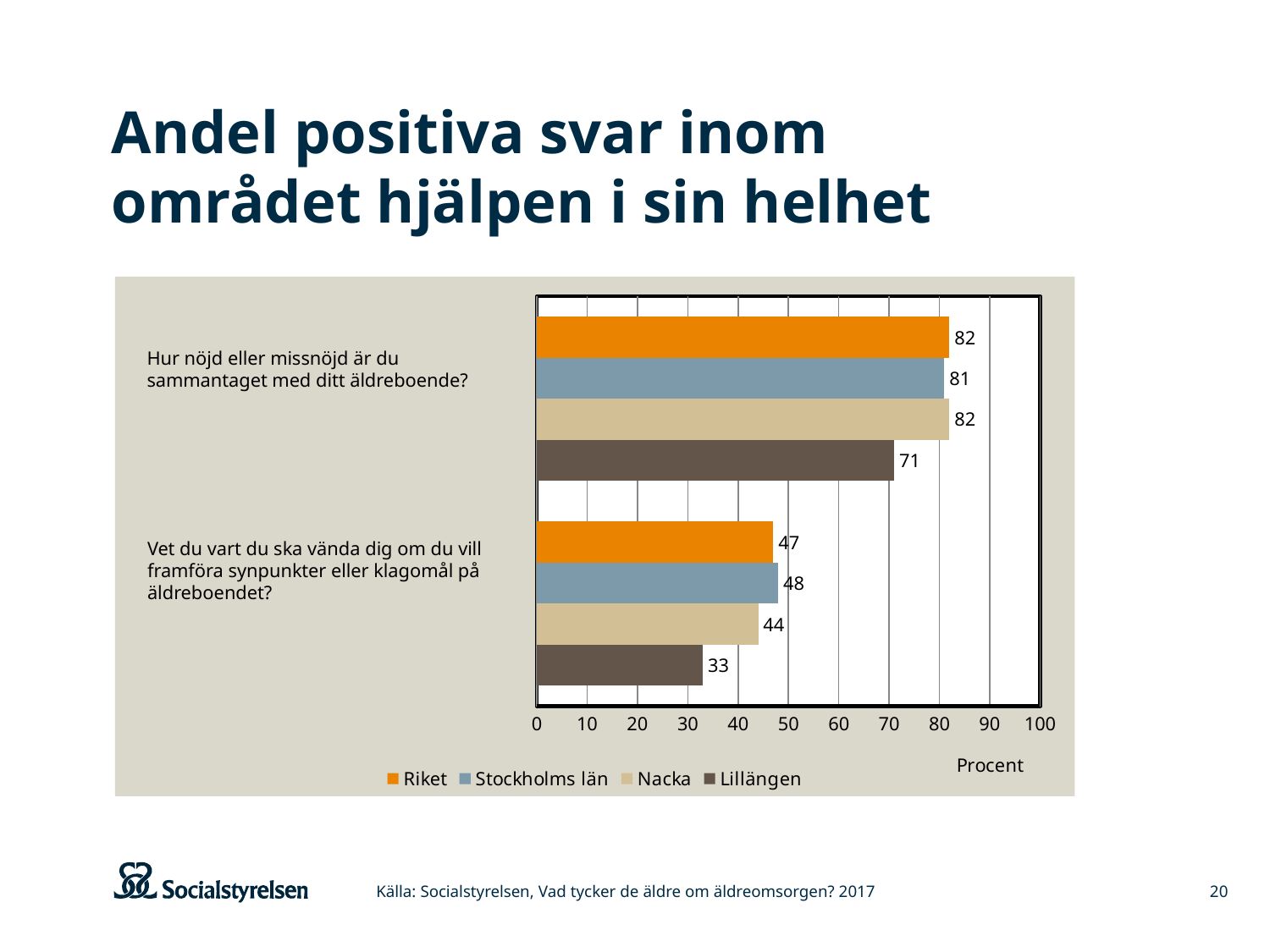
What is the label of the horizontal axis? Procent How many questions (categories) are shown on the chart? 2 Which is larger for Lillängen: the value for 'Hur nöjd eller missnöjd är du sammantaget med ditt äldreboende?' or the value for 'Vet du vart du ska vända dig om du vill framföra synpunkter eller klagomål på äldreboendet?' Hur nöjd eller missnöjd är du sammantaget med ditt äldreboende? What is the difference between Nacka and Lillängen on the question 'Hur nöjd eller missnöjd är du sammantaget med ditt äldreboende?' 11 What is the value for Riket on the question 'Hur nöjd eller missnöjd är du sammantaget med ditt äldreboende?' 82 Which series has the lowest value on the question 'Vet du vart du ska vända dig om du vill framföra synpunkter eller klagomål på äldreboendet?' Lillängen What type of chart is shown on the slide? bar chart What is the value for Stockholms län on the question 'Vet du vart du ska vända dig om du vill framföra synpunkter eller klagomål på äldreboendet?' 48 What is the value for Nacka on the question 'Vet du vart du ska vända dig om du vill framföra synpunkter eller klagomål på äldreboendet?' 44 Which series has the highest value on the question 'Vet du vart du ska vända dig om du vill framföra synpunkter eller klagomål på äldreboendet?' Stockholms län What is the value for Lillängen on the question 'Hur nöjd eller missnöjd är du sammantaget med ditt äldreboende?' 71 How many series does the legend list? 4